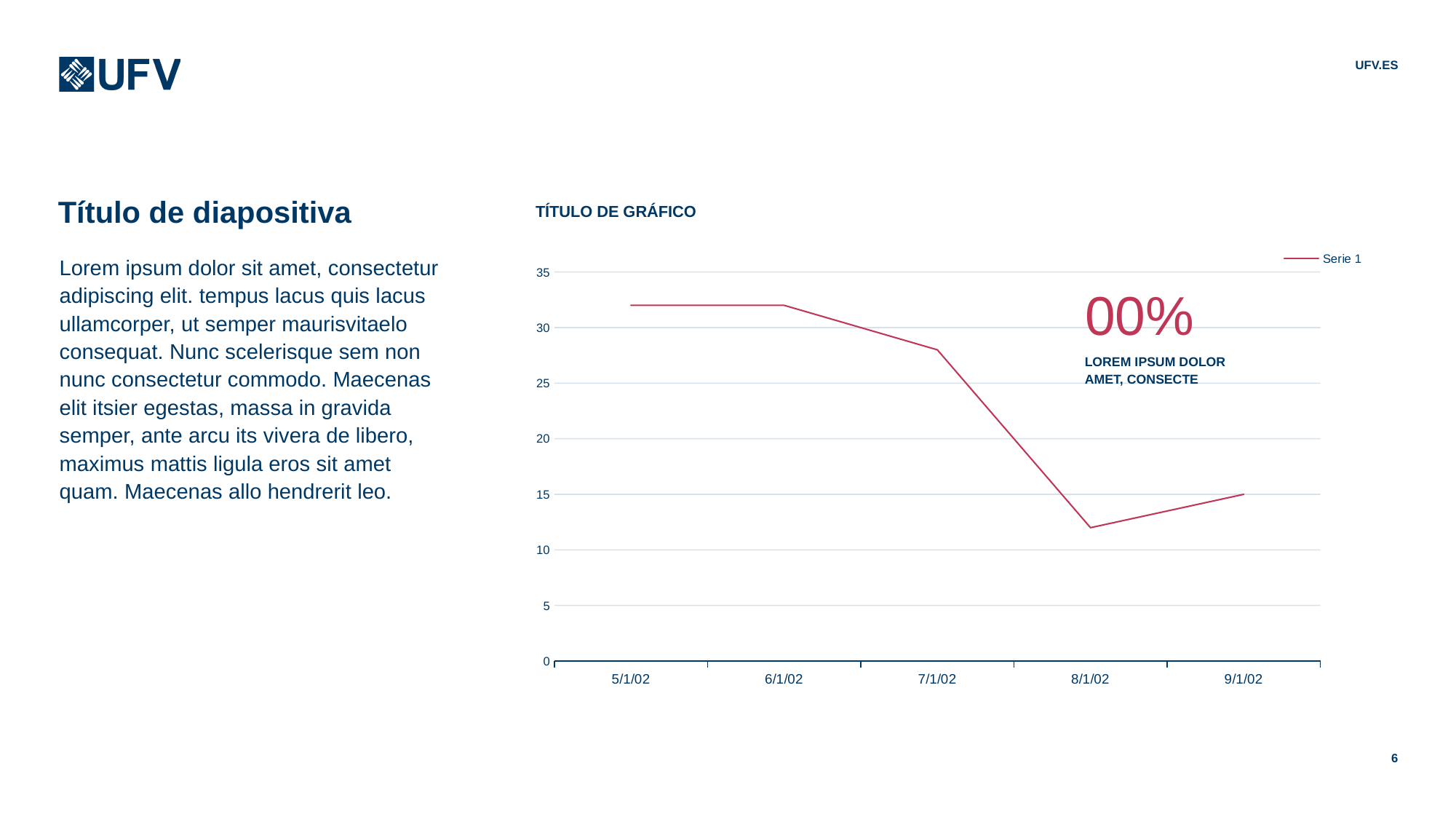
What is the title of the chart? TÍTULO DE GRÁFICO What kind of chart is shown on the slide? line chart Is the value for 8/1/02 greater or less than 15? less What is the value for 9/1/02? 15 Which is larger, the value for 7/1/02 or the value for 8/1/02? 7/1/02 Does the line generally rise or fall from 5/1/02 to 8/1/02? fall What is the name of the series shown in the legend? Serie 1 How many data points are plotted on the line? 5 How many series does the chart legend list? 1 Is the value for 7/1/02 greater or less than 25? greater Which date has the lowest value on the chart? 8/1/02 Is the value for 5/1/02 greater or less than 30? greater